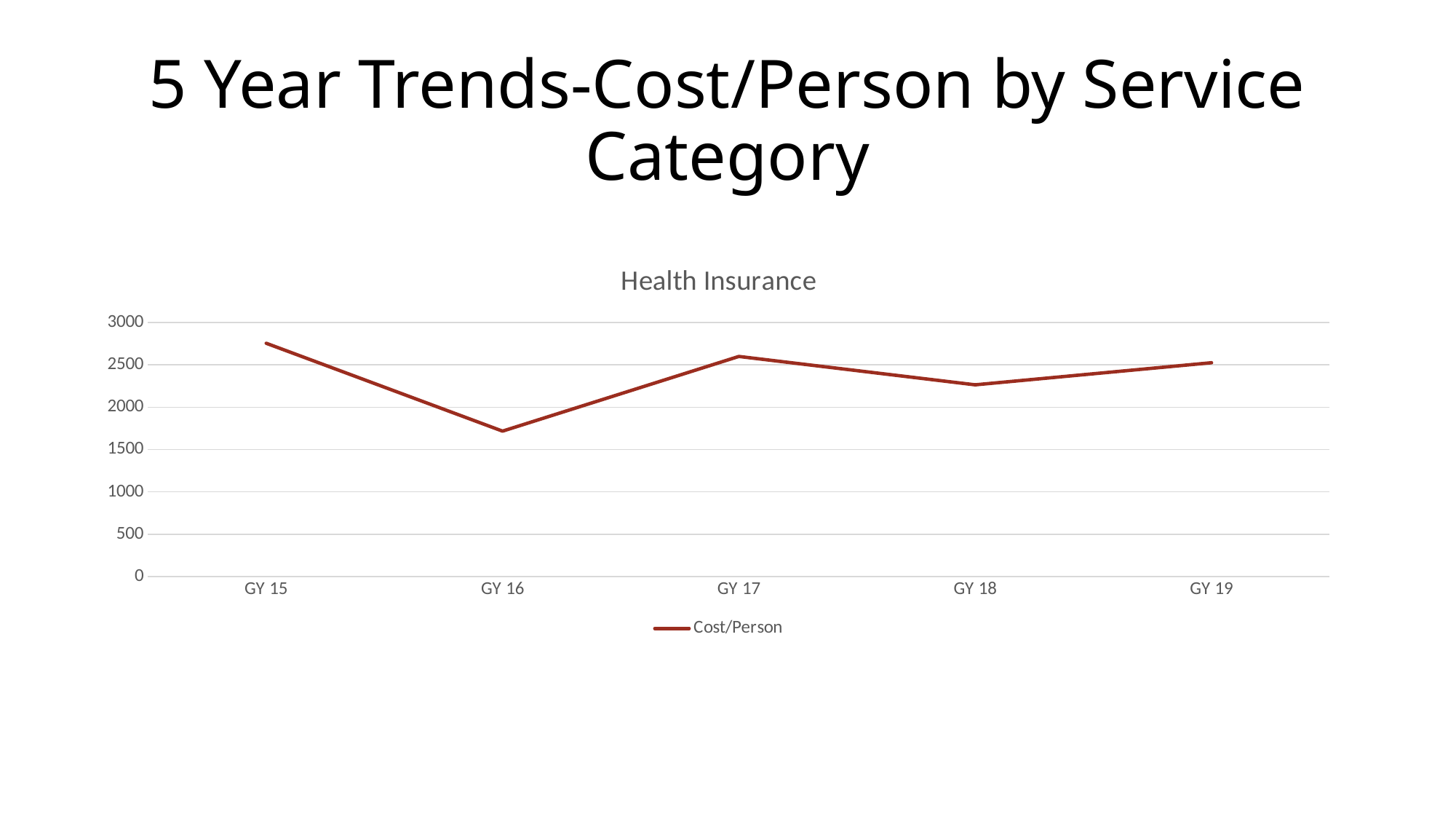
What series name appears in the legend? Cost/Person Does the Cost/Person rise or fall from GY 15 to GY 16? fall What is the title of the chart? Health Insurance How many years are plotted on the x axis? 5 Which year has the lowest Cost/Person? GY 16 Is the Cost/Person for GY 15 greater or less than 2500? greater Is the Cost/Person for GY 16 greater or less than 2000? less Which year has the highest Cost/Person? GY 15 Is the Cost/Person for GY 18 greater or less than 2500? less Which is larger, the Cost/Person for GY 17 or for GY 18? GY 17 What kind of chart is shown on the slide? line chart How many series does the legend list? 1